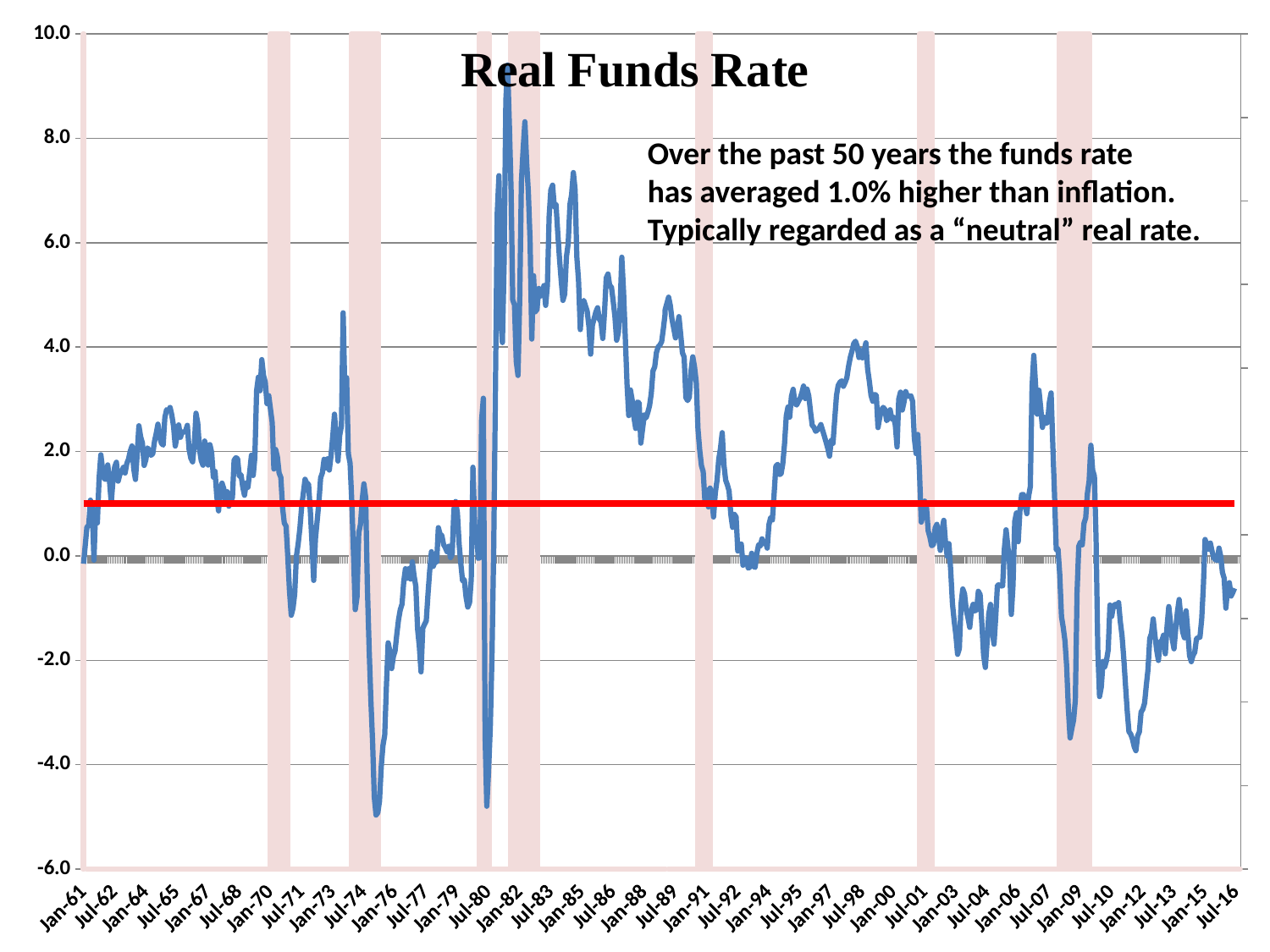
Is the value of the real funds rate at Jul-16 greater or less than 0.0? less Is the value of the real funds rate around Jul-98 greater or less than 2.0? greater Around which x-axis label does the real funds rate reach its highest point? Jan-82 What kind of chart is shown on the slide? line chart Between Jan-92 and Jul-98, does the real funds rate overall rise or fall? rise What is the title of the chart? Real Funds Rate What is the first date label on the x axis? Jan-61 At what level is the red horizontal line drawn on the chart? 1.0 Between Jan-82 and Jan-92, does the real funds rate overall rise or fall? fall Is the value of the real funds rate around Jan-12 greater or less than -2.0? less